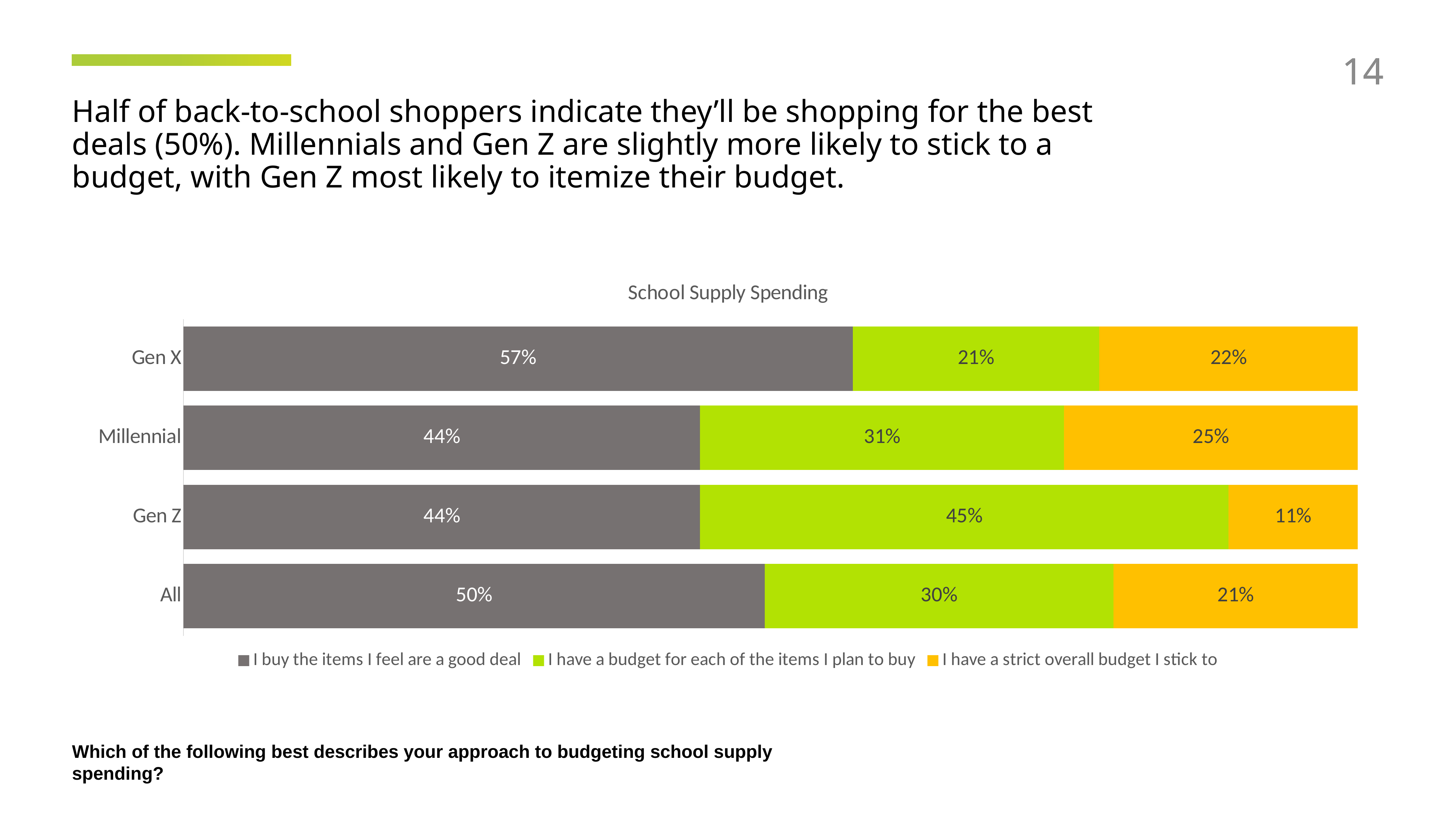
Which group has the lowest share for "I have a strict overall budget I stick to"? Gen Z What is the difference between Gen Z and Gen X for "I have a budget for each of the items I plan to buy"? 24 percentage points Which group has the highest share for "I buy the items I feel are a good deal"? Gen X What kind of chart is shown on the slide? Stacked bar chart What percentage of All respondents say "I buy the items I feel are a good deal"? 50% What percentage of Millennial respondents say "I have a strict overall budget I stick to"? 25% What is the title of the chart? School Supply Spending What percentage of Gen Z respondents say "I have a budget for each of the items I plan to buy"? 45% How many series does the legend list? 3 What percentage of Gen X respondents say "I buy the items I feel are a good deal"? 57% Which is larger: the Millennial share for "I have a strict overall budget I stick to" or the Gen X share for the same response? Millennial How many groups (categories) are shown on the chart? 4